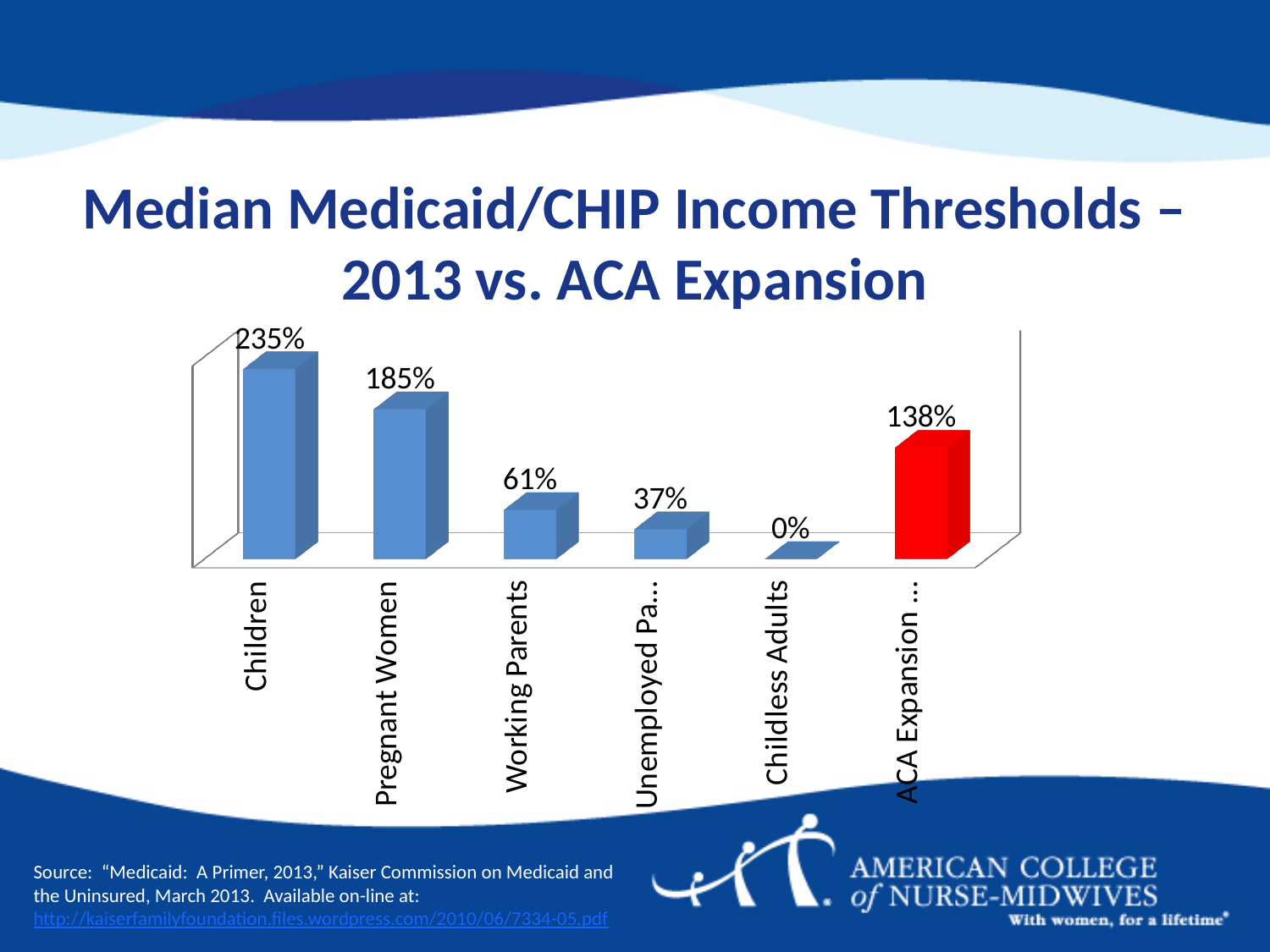
What is the value for Working Parents? 61% How many categories are shown in the chart? 6 What kind of chart is shown on the slide? Bar chart What value is shown on the red bar (ACA Expansion)? 138% Which is larger, the value for Pregnant Women or the value for ACA Expansion? Pregnant Women What is the value for Pregnant Women? 185% Which category has the lowest value? Childless Adults What is the value for Children? 235% Which category has the highest value? Children What is the value for Childless Adults? 0% What colour is the ACA Expansion bar? Red What is the difference between the values for Children and Pregnant Women? 50 percentage points